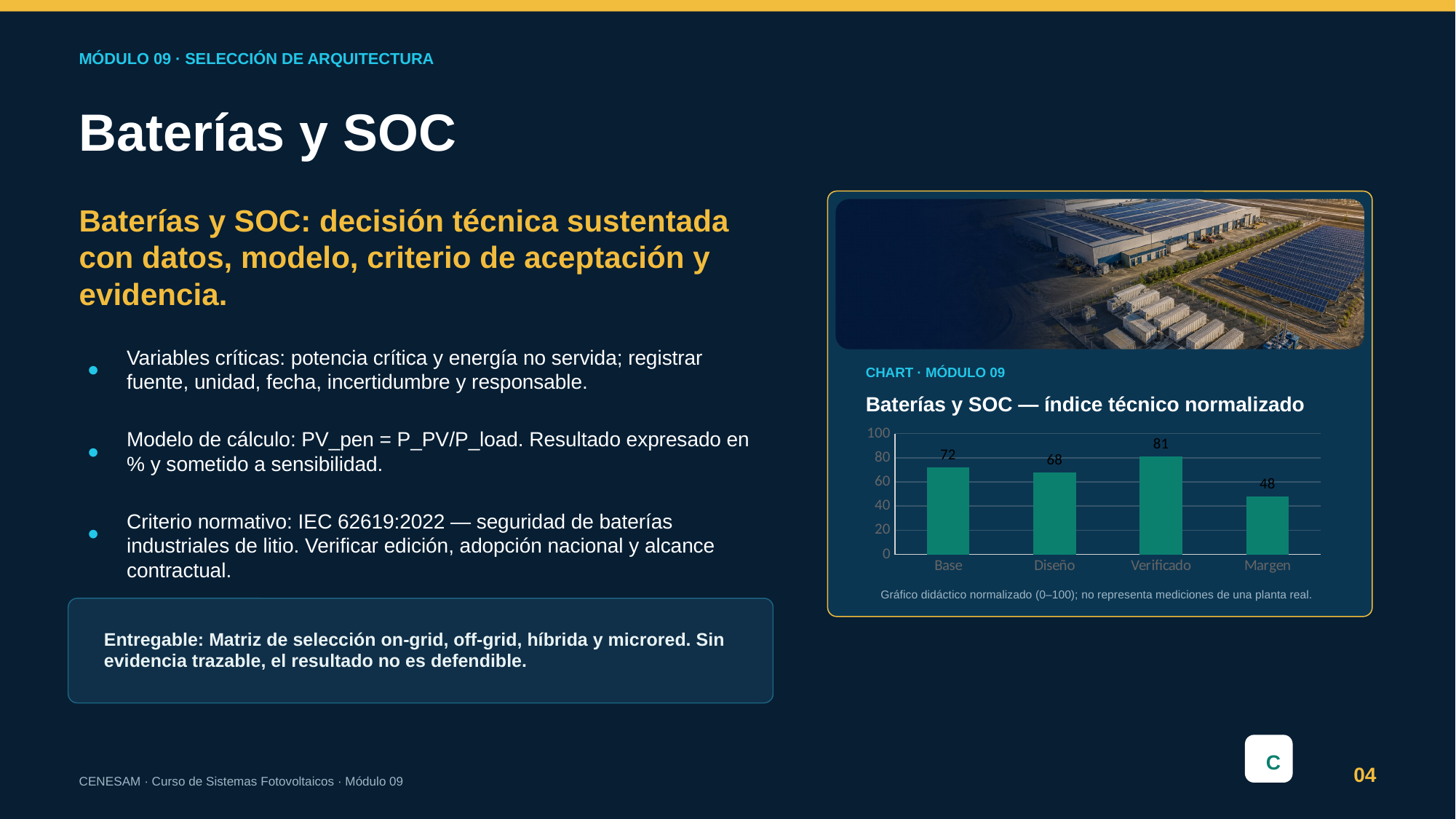
How many categories are shown on the x axis of the chart? 4 Which is larger, the value for Base or the value for Margen? Base What is the difference between the values for Verificado and Margen? 33 What is the value for Margen in the chart? 48 Which category has the lowest value in the chart? Margen What is the value for Diseño in the chart? 68 Is the value for Margen greater or less than 60? less What is the value for Base in the chart? 72 Which category has the highest value in the chart? Verificado What type of chart is shown on the slide? bar chart What is the difference between the values for Base and Diseño? 4 What is the value for Verificado in the chart? 81